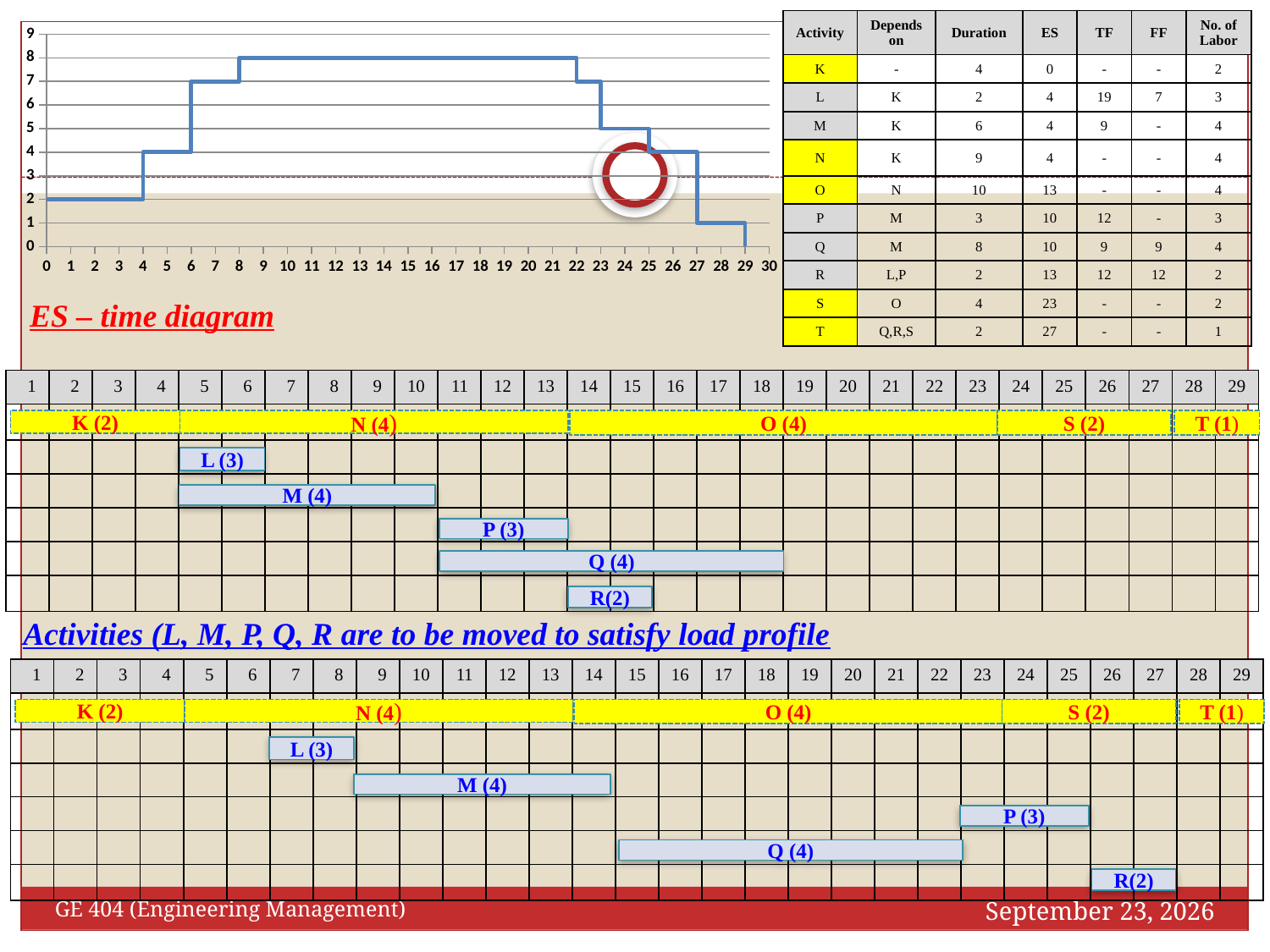
In the 'ES – time diagram', what is the highest labor level the line reaches? 8 What kind of chart is the 'ES – time diagram'? line chart In the 'ES – time diagram', is the value at time 26 greater or less than 5? less In the 'ES – time diagram', is the value at time 7 greater or less than 5? greater In the 'ES – time diagram', what is the value of the line at time 28? 1 In the 'ES – time diagram', which is larger: the value at time 5 or the value at time 24? time 24 In the 'ES – time diagram', what is the difference between the value at time 10 and the value at time 2? 6 In the 'ES – time diagram', what is the value of the line at time 2? 2 In the 'ES – time diagram', what is the value of the line at time 10? 8 What is the title of the step chart at the top left of the slide? ES – time diagram In the 'ES – time diagram', what is the value of the line at time 24? 5 In the 'ES – time diagram', does the line rise or fall between time 22 and time 29? fall